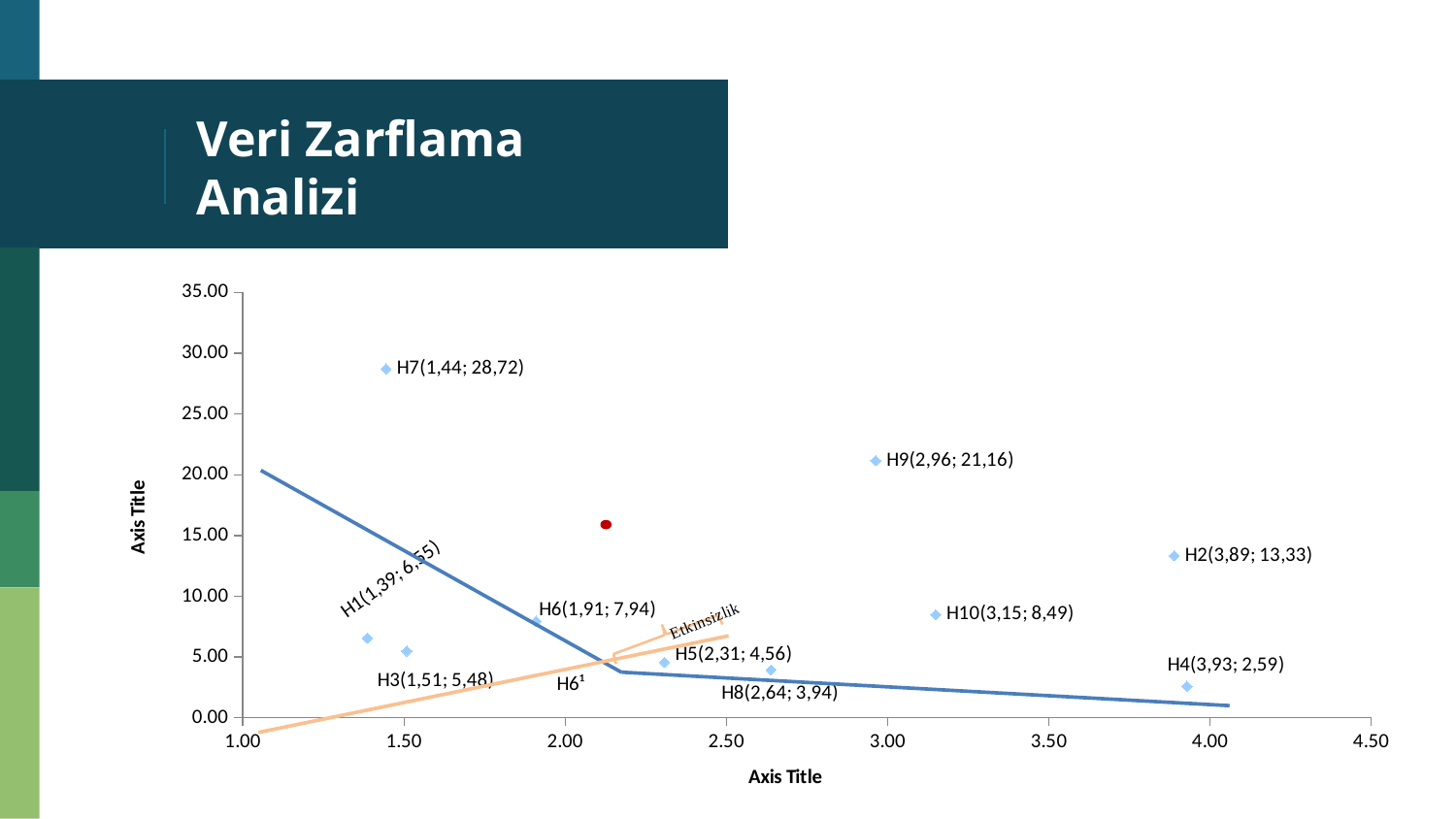
What are the coordinates printed for point H2? (3,89; 13,33) What is the difference between the y values of H7 and H9? 7,56 What are the coordinates printed for point H9? (2,96; 21,16) Which has a larger y value, H10 or H6? H10 Is the y value of the red dot greater or less than 10.00? greater Which labeled point has the highest vertical (y) value? H7 Which labeled point has the lowest vertical (y) value? H4 What are the coordinates printed for point H7? (1,44; 28,72) What is the title of the slide containing the chart? Veri Zarflama Analizi What are the coordinates printed for point H4? (3,93; 2,59) What kind of chart is shown on the slide? Scatter chart How many labeled H points are plotted on the chart? 10